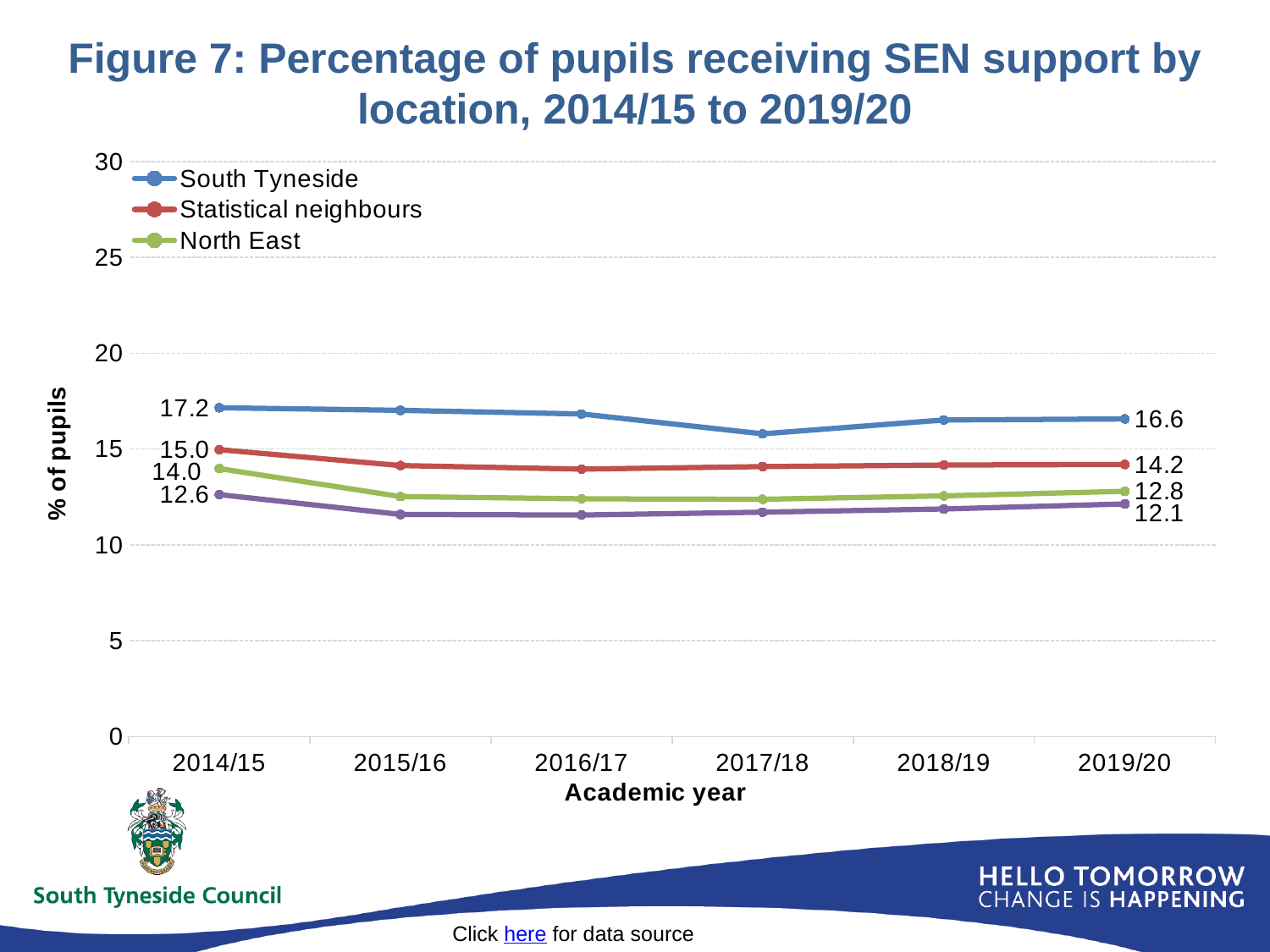
Is the value for South Tyneside in 2017/18 greater or less than 15? greater What was the percentage of pupils receiving SEN support in South Tyneside in 2019/20? 16.6 How many academic years are shown on the x axis? 6 What was the value for Statistical neighbours in 2019/20? 14.2 By how much did the South Tyneside percentage change between 2014/15 and 2019/20? 0.6 Which series had the highest value in 2019/20? South Tyneside What was the value for North East in 2014/15? 14.0 Did the North East percentage rise or fall from 2014/15 to 2019/20? Fall What is the difference between South Tyneside and Statistical neighbours in 2014/15? 2.2 How many series does the legend list? 3 What was the percentage of pupils receiving SEN support in South Tyneside in 2014/15? 17.2 What type of chart is shown on the slide? Line chart